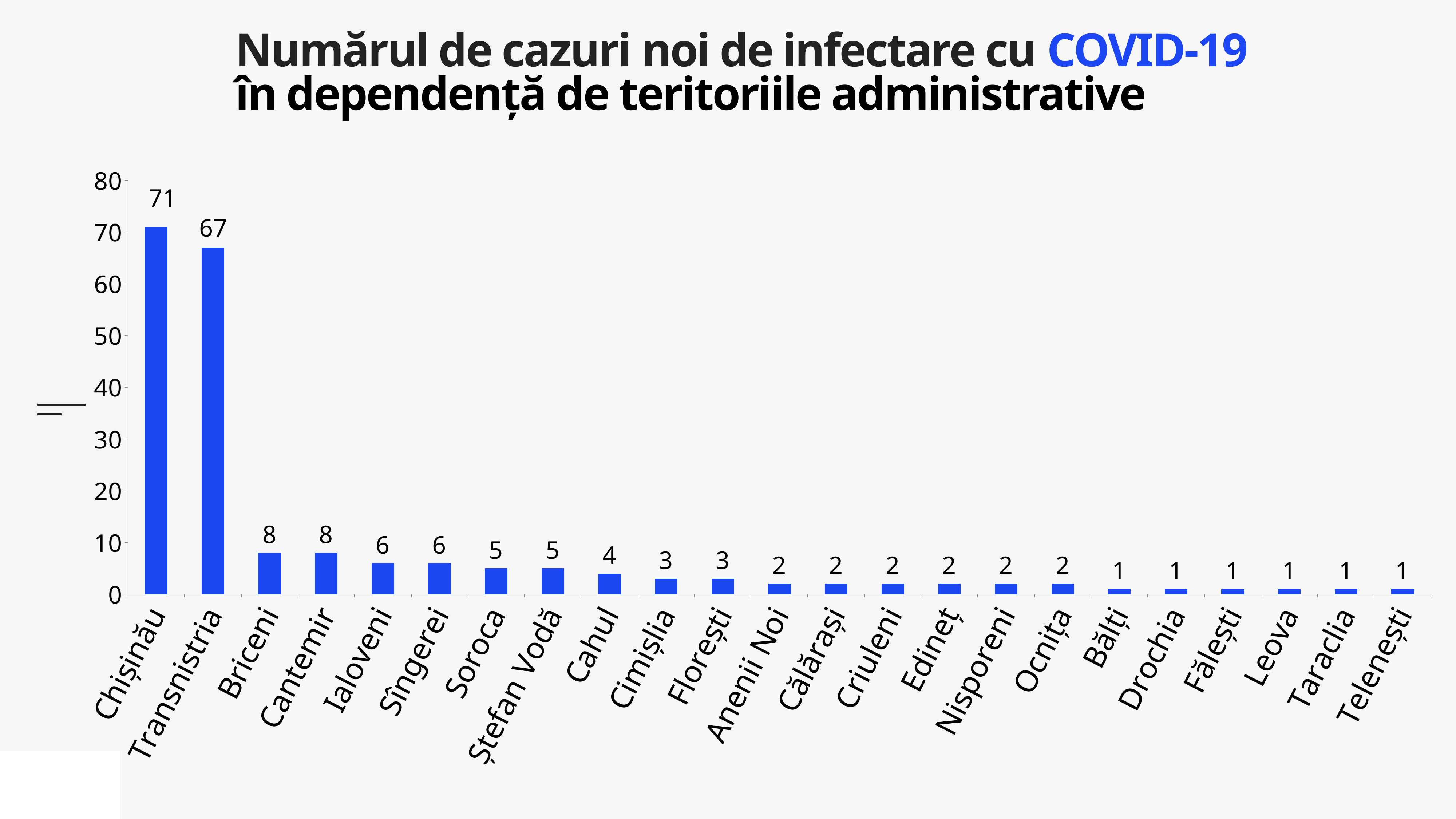
Which is larger, the value for Ialoveni or the value for Florești? Ialoveni What is the value for Chișinău? 71 What is the difference between the values for Briceni and Soroca? 3 Do the values rise or fall from left to right along the x axis? fall What kind of chart is shown on the slide? bar chart Which territory has the highest number of new cases? Chișinău What is the value for Cahul? 4 What is the value for Transnistria? 67 How many territories are shown on the chart? 23 What is the difference between the values for Chișinău and Transnistria? 4 Is the value for Transnistria greater or less than 60? greater What is the value for Ocnița? 2